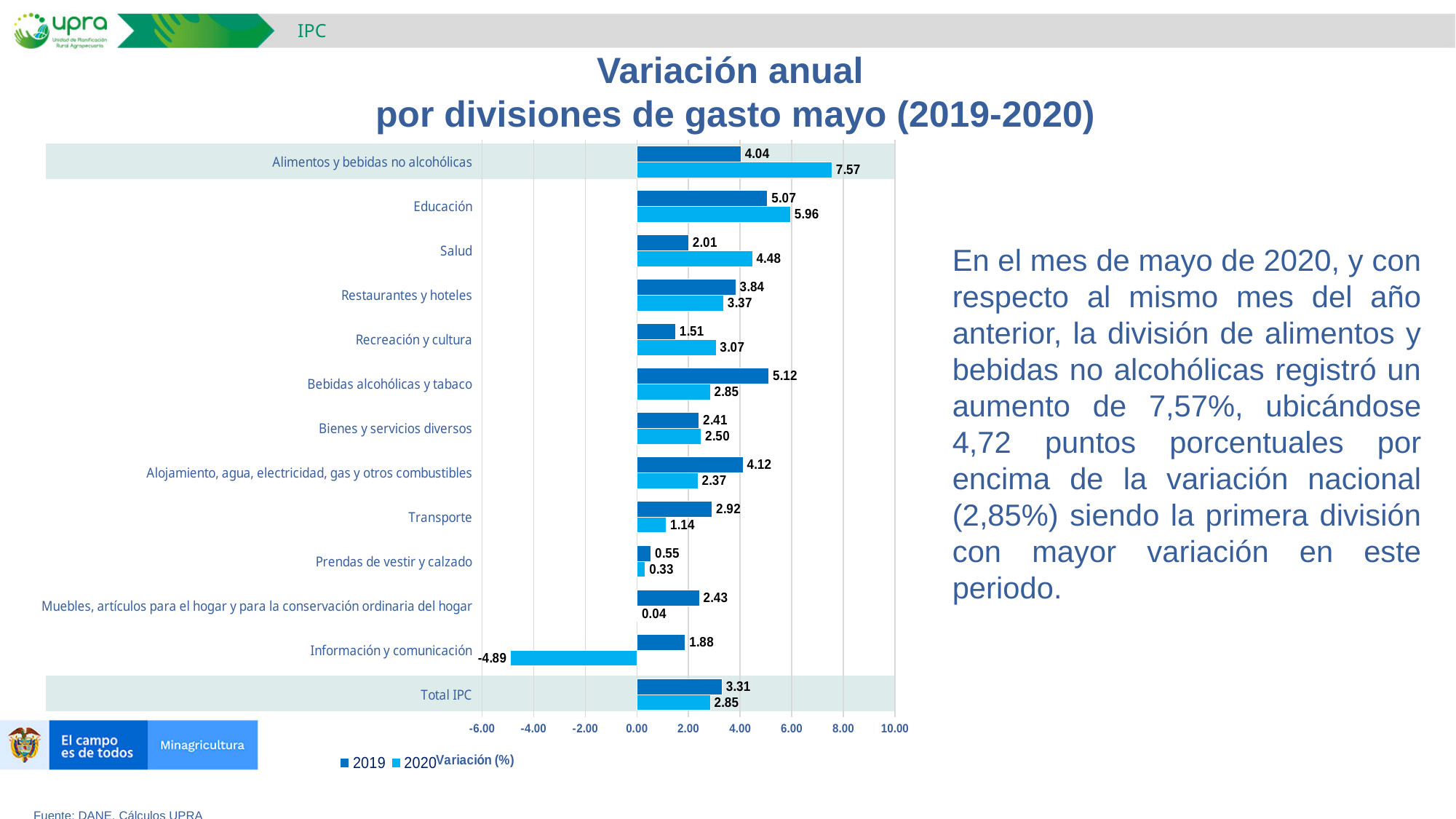
What is the 2020 value for Alimentos y bebidas no alcohólicas? 7.57 Which category has the highest 2019 value? Bebidas alcohólicas y tabaco What is the 2019 value for Total IPC? 3.31 How many categories are shown on the chart, including Total IPC? 13 How many series does the legend list? 2 Which category has the lowest 2020 value? Información y comunicación What kind of chart is shown on the slide? Bar chart Which category has the highest 2020 value? Alimentos y bebidas no alcohólicas Which is larger for Transporte, the 2019 value or the 2020 value? 2019 What is the difference between the 2020 and 2019 values for Salud? 2.47 What is the 2019 value for Educación? 5.07 What is the 2020 value for Información y comunicación? -4.89